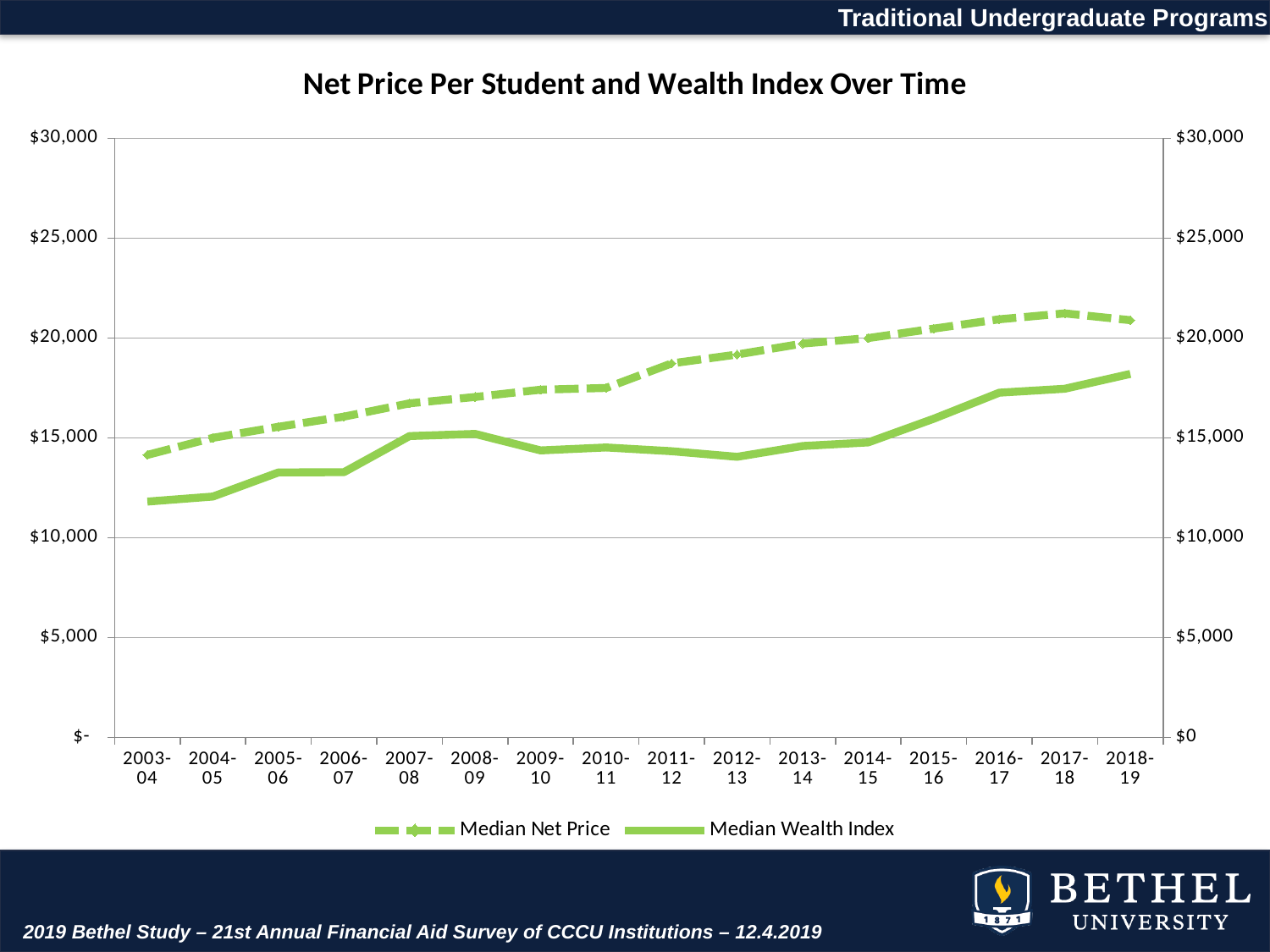
Is the Median Net Price for 2003-04 greater or less than $15,000? less Is the Median Wealth Index for 2012-13 greater or less than $15,000? less In which year is the Median Wealth Index at its lowest? 2003-04 In 2003-04, which is larger: the Median Net Price or the Median Wealth Index? Median Net Price How many academic years are plotted along the x axis? 16 What type of chart is shown on the slide? Line chart Is the Median Net Price for 2017-18 greater or less than $20,000? greater How many series does the legend list? 2 What is the title of the chart? Net Price Per Student and Wealth Index Over Time In which year is the Median Wealth Index at its highest? 2018-19